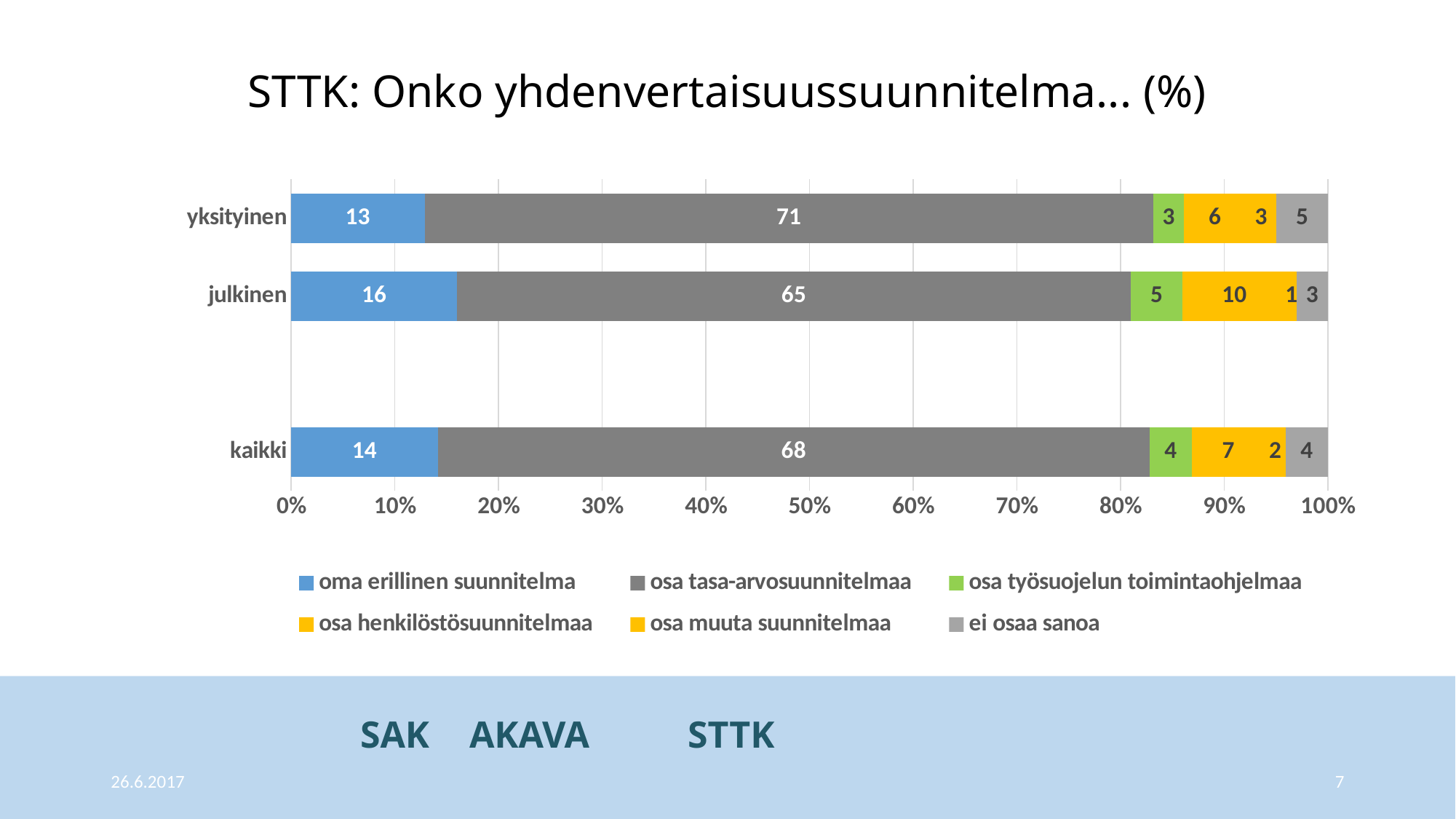
What is the title of the chart? STTK: Onko yhdenvertaisuussuunnitelma... (%) What type of chart is shown on the slide? stacked bar chart Which category has the lowest value for 'oma erillinen suunnitelma'? yksityinen Which category has the highest value for 'osa tasa-arvosuunnitelmaa'? yksityinen What is the difference between the 'osa tasa-arvosuunnitelmaa' values for yksityinen and julkinen? 6 How many series does the legend list? 6 How many categories are shown on the vertical axis of the chart? 3 What is the value of 'osa tasa-arvosuunnitelmaa' for yksityinen? 71 What is the value of 'oma erillinen suunnitelma' for julkinen? 16 What is the value of 'ei osaa sanoa' for kaikki? 4 What is the value of 'osa työsuojelun toimintaohjelmaa' for julkinen? 5 Which is larger: the 'oma erillinen suunnitelma' value for julkinen or for kaikki? julkinen